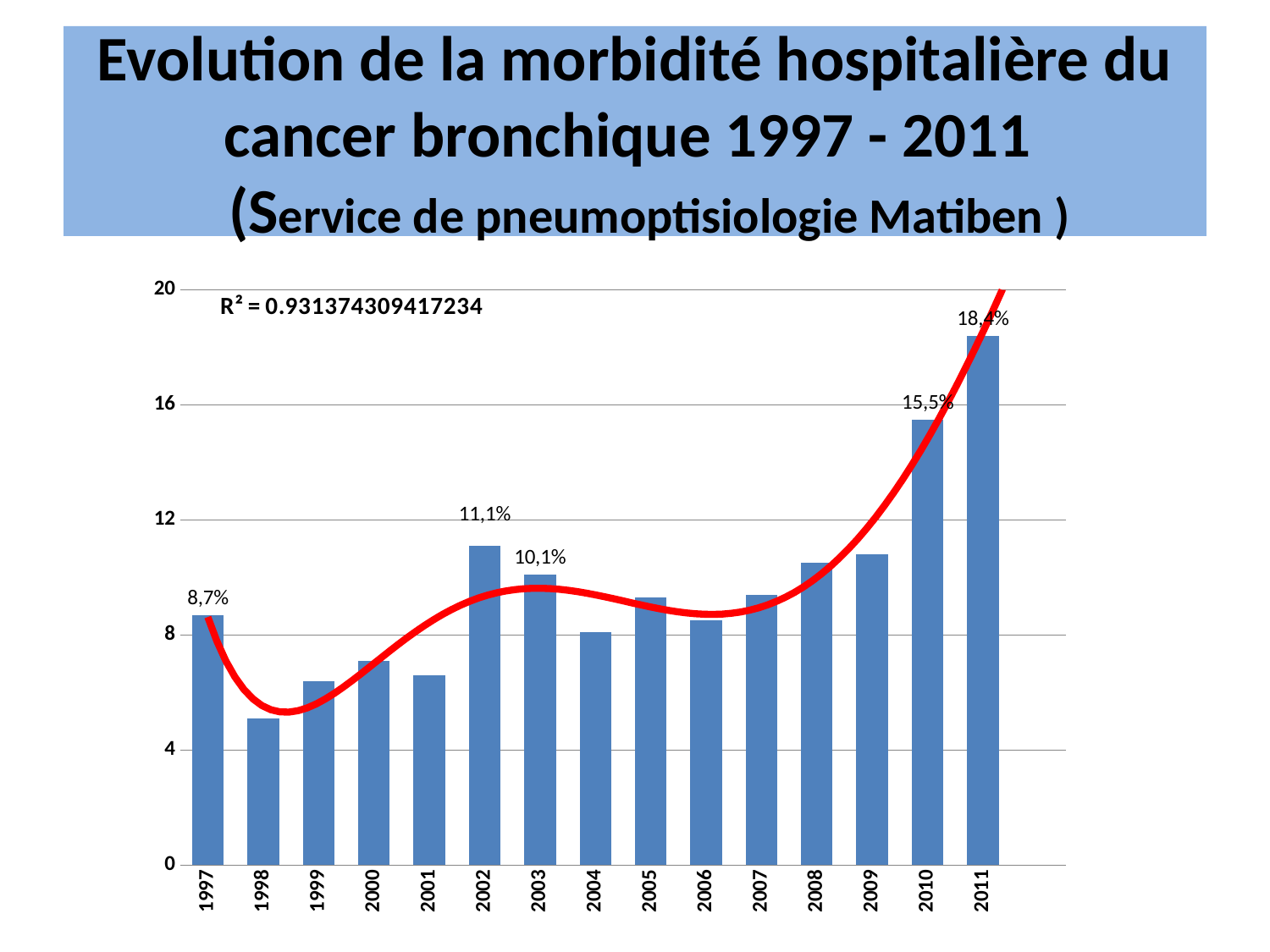
What is the difference between the values for 2011 and 2010? 2,9 percentage points What is the value for 1997? 8,7% Which year has the lowest value? 1998 What R² value is printed on the chart? 0.931374309417234 How many years are shown on the x axis? 15 Which year has the larger value, 2002 or 2003? 2002 What is the value for 2011? 18,4% Is the value for 1998 greater or less than 8? less What is the value for 2010? 15,5% What is the value for 2003? 10,1% What kind of chart is this? bar chart Which year has the highest value? 2011